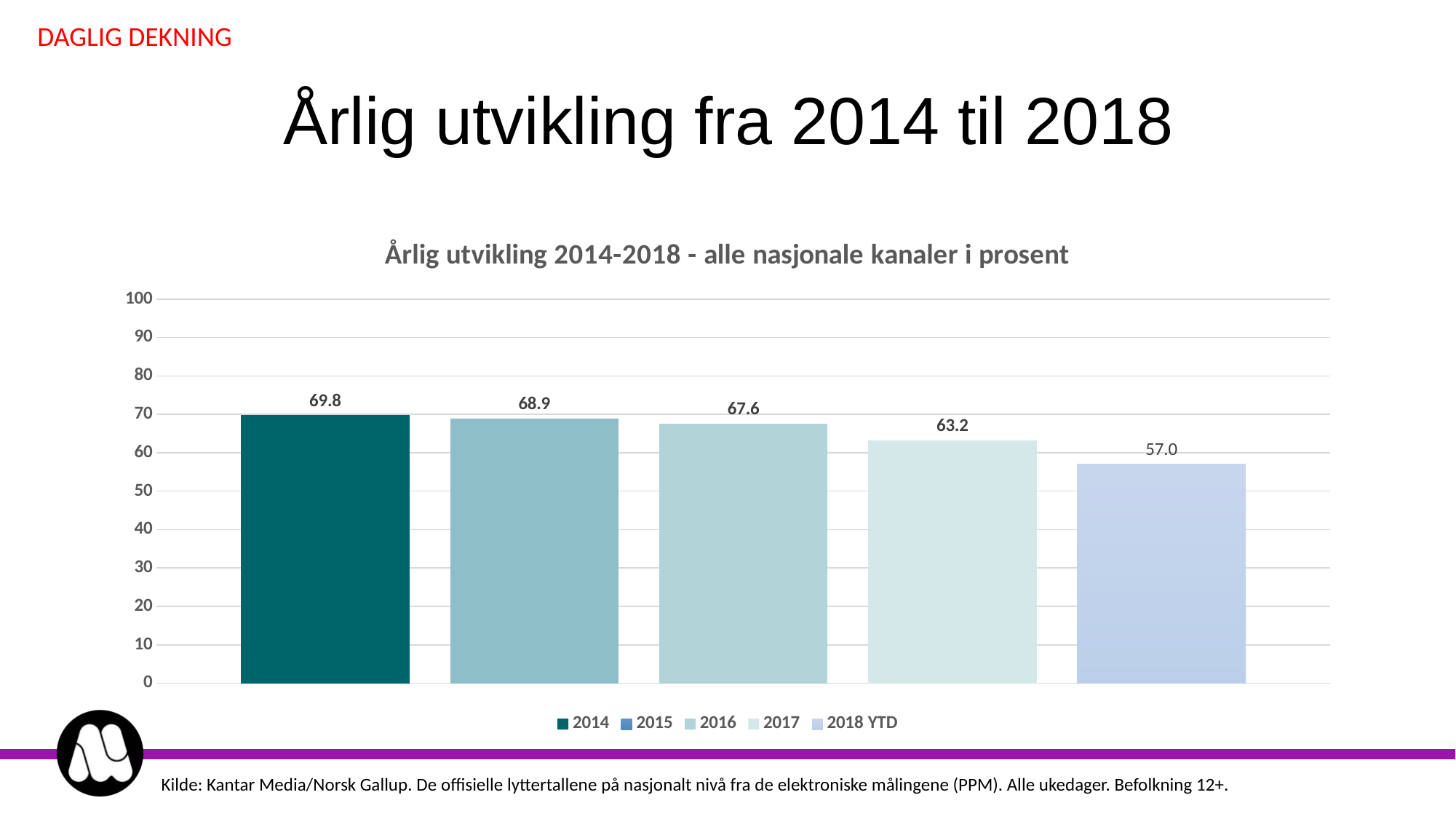
What is the difference between the values for 2016 and 2017? 4.4 Which is larger, the value for 2015 or the value for 2017? 2015 How many bars are shown in the chart? 5 Do the values rise or fall from 2014 to 2018 YTD? fall Which year has the lowest value? 2018 YTD What is the difference between the values for 2014 and 2018 YTD? 12.8 Which year has the highest value? 2014 What is the value for 2017? 63.2 What is the value for 2018 YTD? 57.0 What kind of chart is shown on the slide? bar chart What is the value for 2014? 69.8 Is the value for 2018 YTD greater or less than 60? less